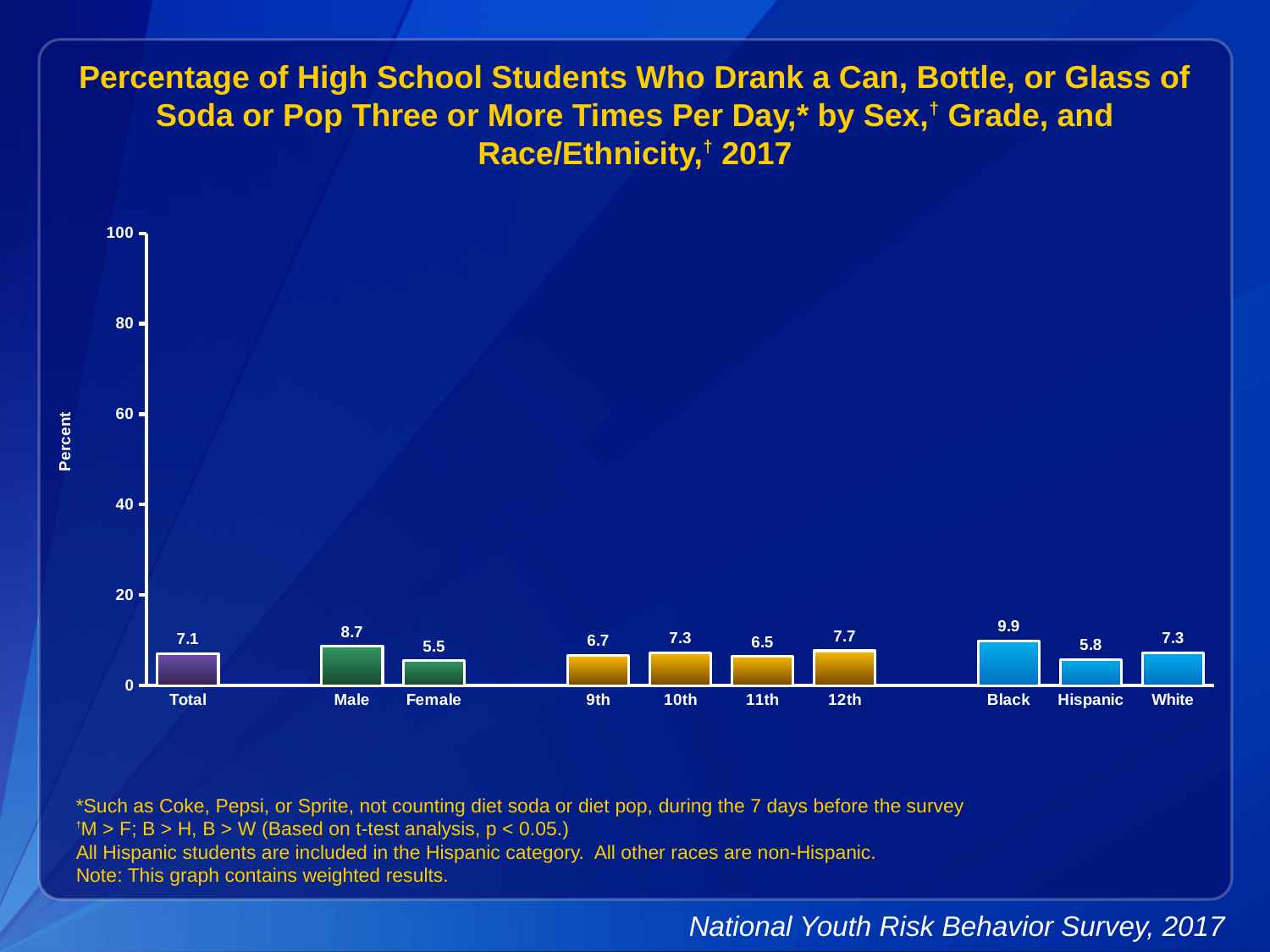
What is the difference between the values for Male and Female? 3.2 Which is larger, the value for Black or the value for White? Black Which category has the lowest value? Female What is the value for Total? 7.1 Is the value for 12th greater or less than 20? less What is the label of the y axis? Percent What kind of chart is this? bar chart How many categories are shown on the x axis? 10 What is the value for Hispanic? 5.8 What is the difference between the values for Black and Hispanic? 4.1 What is the value for Male? 8.7 Which category has the highest value? Black